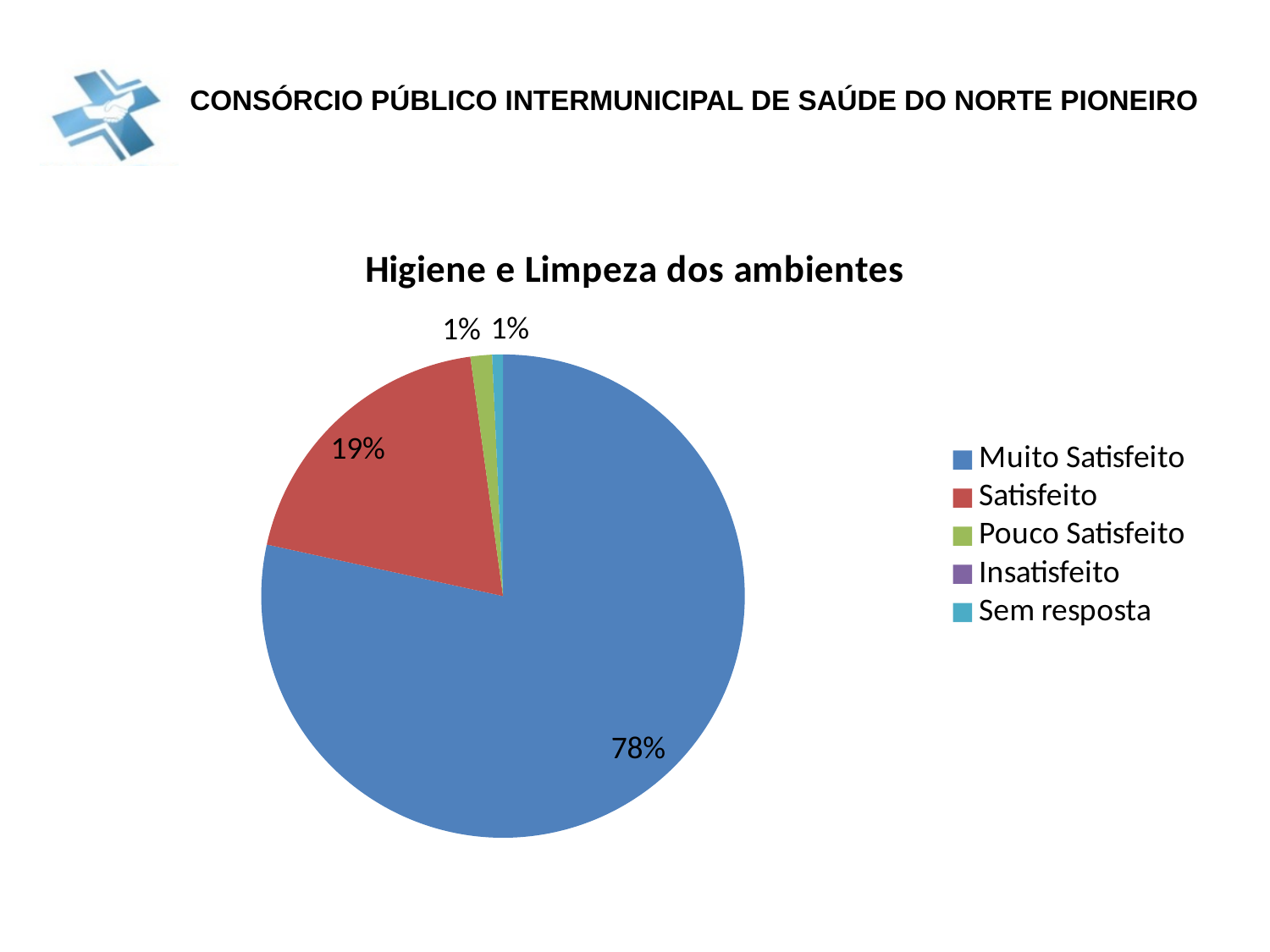
What percentage is shown for the Pouco Satisfeito slice? 1% Which category has the largest slice of the pie? Muito Satisfeito What percentage is shown for the Satisfeito slice? 19% What percentage of the pie is labelled for Muito Satisfeito? 78% What colour is the Satisfeito slice in the pie chart? Red Which slice is larger, Satisfeito or Pouco Satisfeito? Satisfeito How many categories does the legend list? 5 What is the title of the chart? Higiene e Limpeza dos ambientes What is the difference in percentage points between the Muito Satisfeito and Satisfeito slices? 59 What share of the pie does Muito Satisfeito represent? 78% What percentage is shown for the Sem resposta slice? 1% What kind of chart is shown on the slide? Pie chart